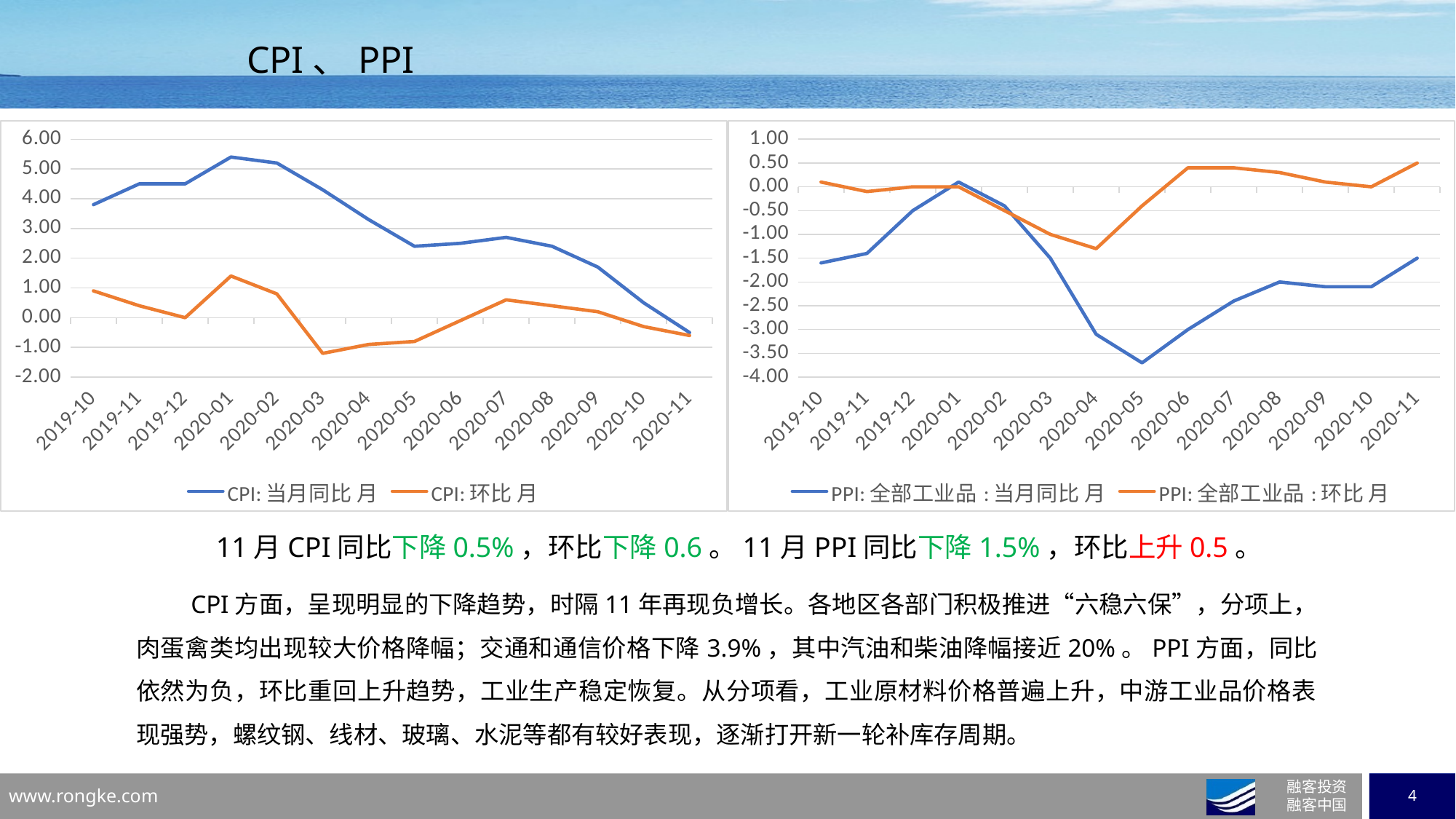
In the right chart (PPI), is the value for PPI: 全部工业品:环比 月 in 2020-04 greater or less than -1.00? less How many months are plotted along the x axis of the left chart (CPI)? 14 In the right chart (PPI), which month has the lowest value for PPI: 全部工业品:当月同比 月? 2020-05 In the right chart (PPI), which month has the lowest value for PPI: 全部工业品:环比 月? 2020-04 In the right chart (PPI), is the value for PPI: 全部工业品:当月同比 月 in 2020-05 greater or less than -3.50? less How many series does the legend of the right chart (PPI) list? 2 In the left chart (CPI), which series has the larger value in 2020-01, CPI: 当月同比 月 or CPI: 环比 月? CPI: 当月同比 月 In the left chart (CPI), does CPI: 当月同比 月 rise or fall from 2020-02 to 2020-05? fall In the left chart (CPI), is the value for CPI: 当月同比 月 in 2020-01 greater or less than 5.00? greater What kind of chart is the left chart (CPI)? line chart In the left chart (CPI), which month has the lowest value for CPI: 当月同比 月? 2020-11